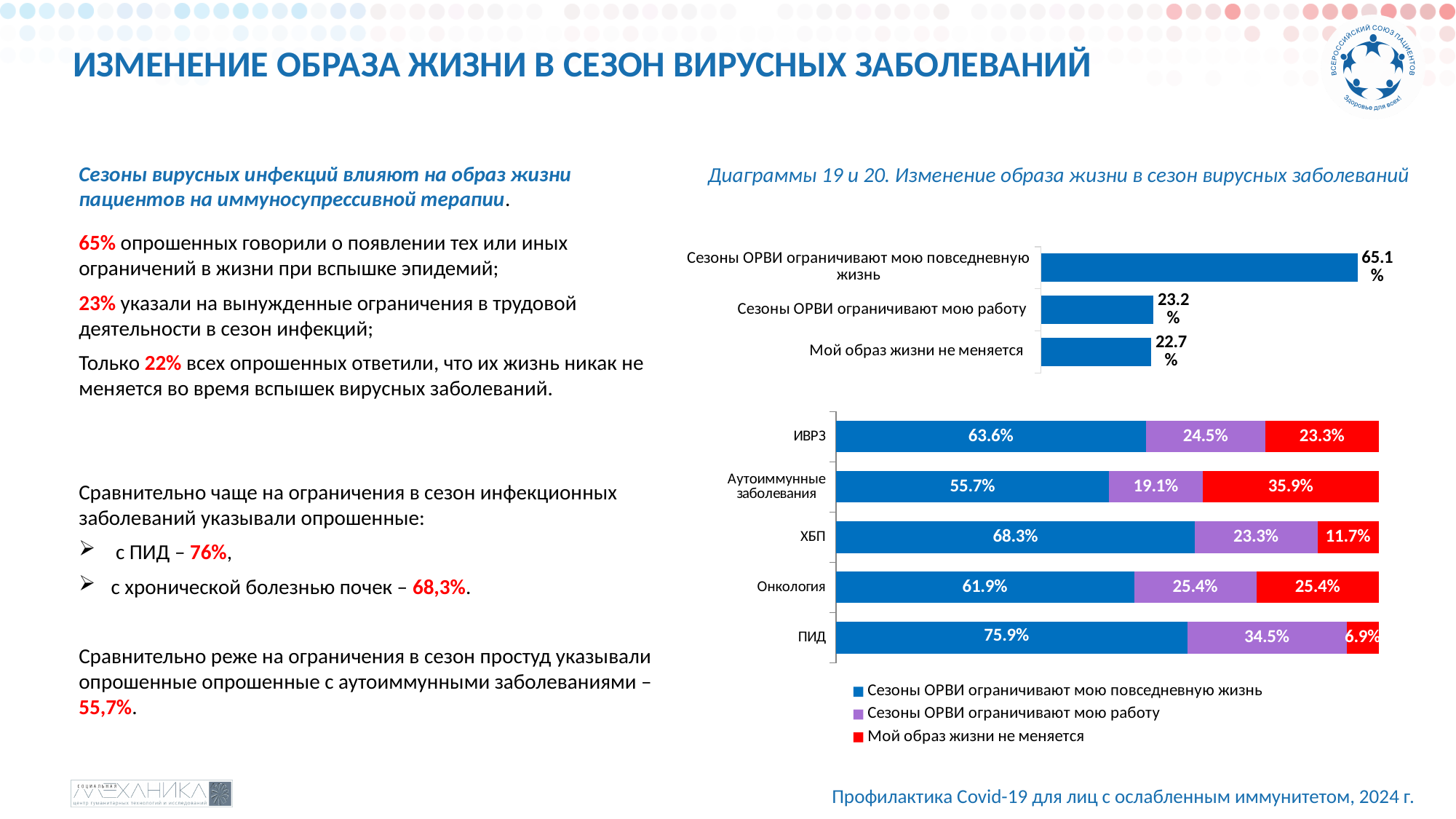
What type of chart is the bottom chart? Stacked bar chart How many series does the legend of the bottom chart list? 3 In the bottom chart, what is the value of 'Мой образ жизни не меняется' for 'Аутоиммунные заболевания'? 35.9% In the bottom chart, which is larger for 'Сезоны ОРВИ ограничивают мою повседневную жизнь': ХБП or Онкология? ХБП In the top chart, what is the difference between 'Сезоны ОРВИ ограничивают мою работу' and 'Мой образ жизни не меняется'? 0.5% In the bottom chart, what is the value of 'Сезоны ОРВИ ограничивают мою повседневную жизнь' for ПИД? 75.9% In the bottom chart, what is the difference between the 'Сезоны ОРВИ ограничивают мою повседневную жизнь' values for ПИД and 'Аутоиммунные заболевания'? 20.2% In the top chart, what is the value for 'Сезоны ОРВИ ограничивают мою повседневную жизнь'? 65.1% In the bottom chart, which category has the lowest value for 'Мой образ жизни не меняется'? ПИД In the bottom chart, which category has the highest value for 'Сезоны ОРВИ ограничивают мою работу'? ПИД In the top chart, which category has the lowest value? Мой образ жизни не меняется In the top chart, how many categories are shown? 3